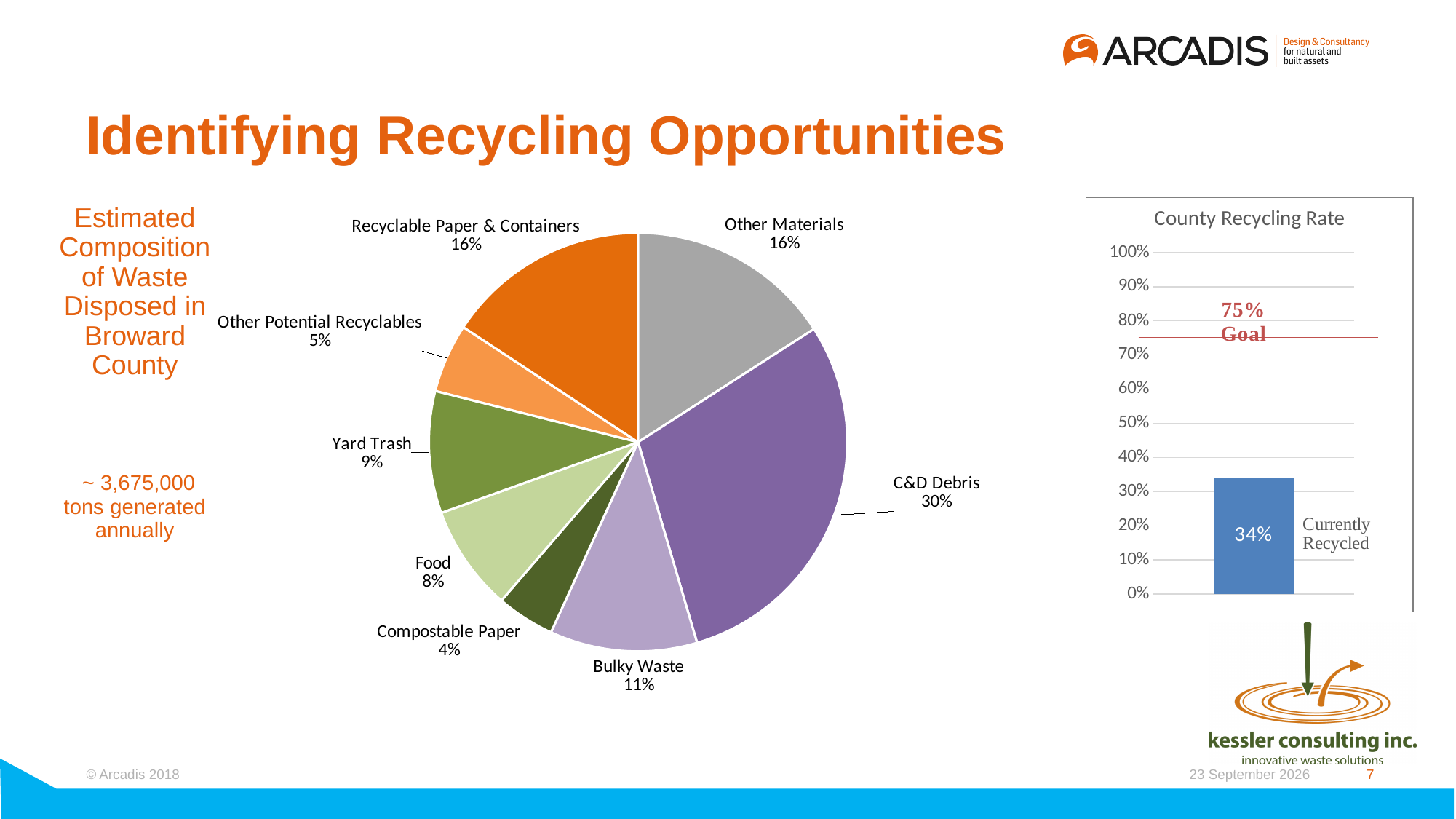
In the pie chart of estimated waste composition, which category has the smallest share? Compostable Paper In the County Recycling Rate chart, what goal percentage is marked by the horizontal line? 75% In the pie chart of estimated waste composition, how many categories are shown? 8 In the pie chart of estimated waste composition, what share is C&D Debris? 30% In the County Recycling Rate chart, what is the value of the Currently Recycled bar? 34% In the pie chart of estimated waste composition, which category has the largest share? C&D Debris In the pie chart of estimated waste composition, what share is Other Potential Recyclables? 5% In the pie chart of estimated waste composition, what share is Compostable Paper? 4% In the pie chart of estimated waste composition, what share is Bulky Waste? 11% What type of chart is the County Recycling Rate chart? Bar chart In the pie chart of estimated waste composition, which is larger: Food or Yard Trash? Yard Trash In the pie chart of estimated waste composition, what is the difference between the shares of C&D Debris and Yard Trash? 21 percentage points